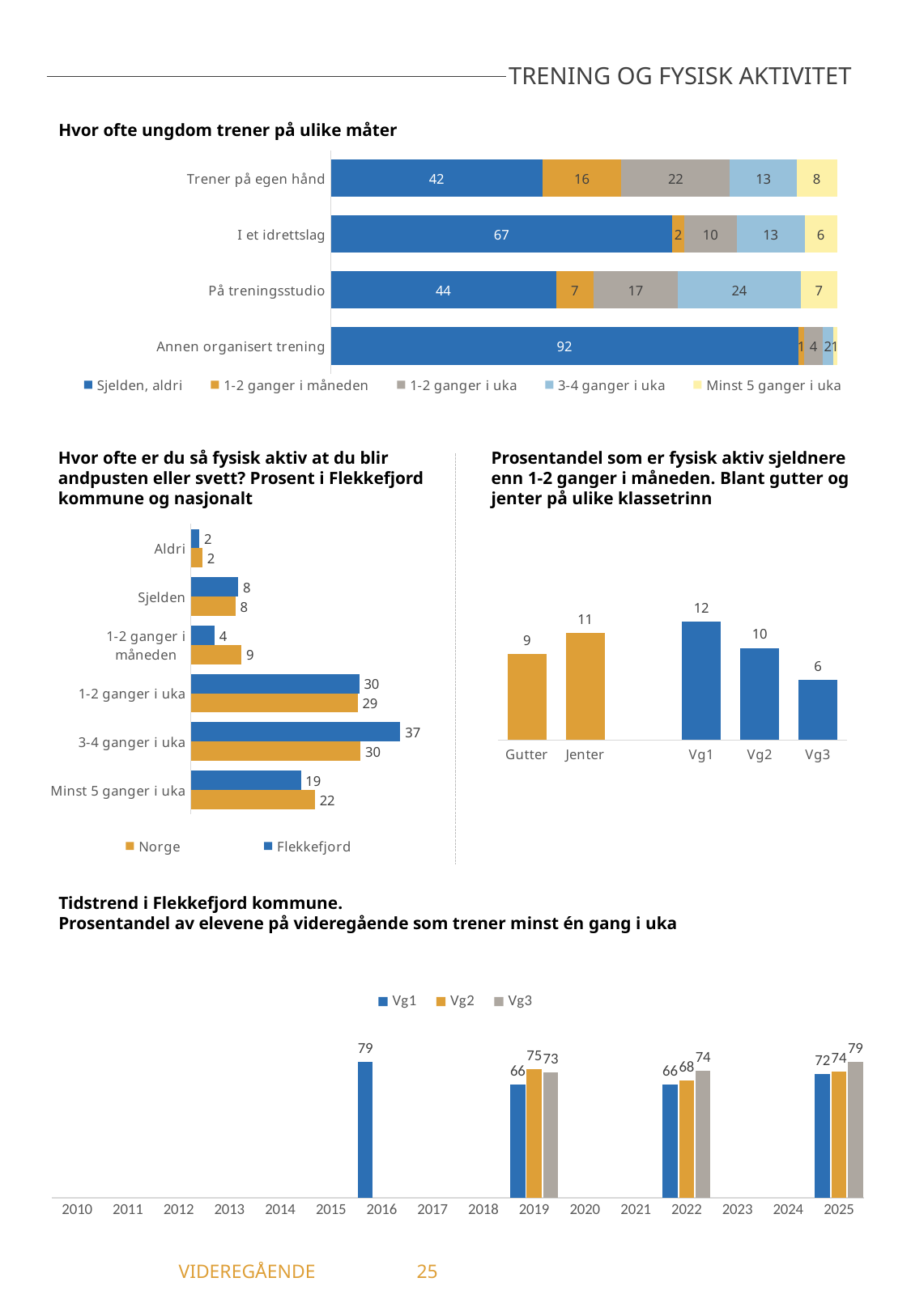
What kind of chart is 'Tidstrend i Flekkefjord kommune'? Bar chart In the chart 'Prosentandel som er fysisk aktiv sjeldnere enn 1-2 ganger i måneden', what is the value for Jenter? 11 In the chart 'Hvor ofte ungdom trener på ulike måter', what is the value for '3-4 ganger i uka' for 'På treningsstudio'? 24 In the chart 'Hvor ofte er du så fysisk aktiv at du blir andpusten eller svett?', what is the difference between Norge and Flekkefjord for '1-2 ganger i måneden'? 5 In the chart 'Tidstrend i Flekkefjord kommune', what is the value for Vg3 in 2025? 79 In the chart 'Prosentandel som er fysisk aktiv sjeldnere enn 1-2 ganger i måneden', how many categories are shown? 5 In the chart 'Hvor ofte ungdom trener på ulike måter', how many series does the legend list? 5 In the chart 'Hvor ofte ungdom trener på ulike måter', what is the value for 'Sjelden, aldri' for 'Annen organisert trening'? 92 In the chart 'Prosentandel som er fysisk aktiv sjeldnere enn 1-2 ganger i måneden', which category has the highest value? Vg1 In the chart 'Hvor ofte ungdom trener på ulike måter', what is the total of the stacked bar for 'I et idrettslag'? 98 In the chart 'Hvor ofte er du så fysisk aktiv at du blir andpusten eller svett?', which is larger for 'Minst 5 ganger i uka', Norge or Flekkefjord? Norge In the chart 'Hvor ofte er du så fysisk aktiv at du blir andpusten eller svett?', what is the value for Flekkefjord for '3-4 ganger i uka'? 37